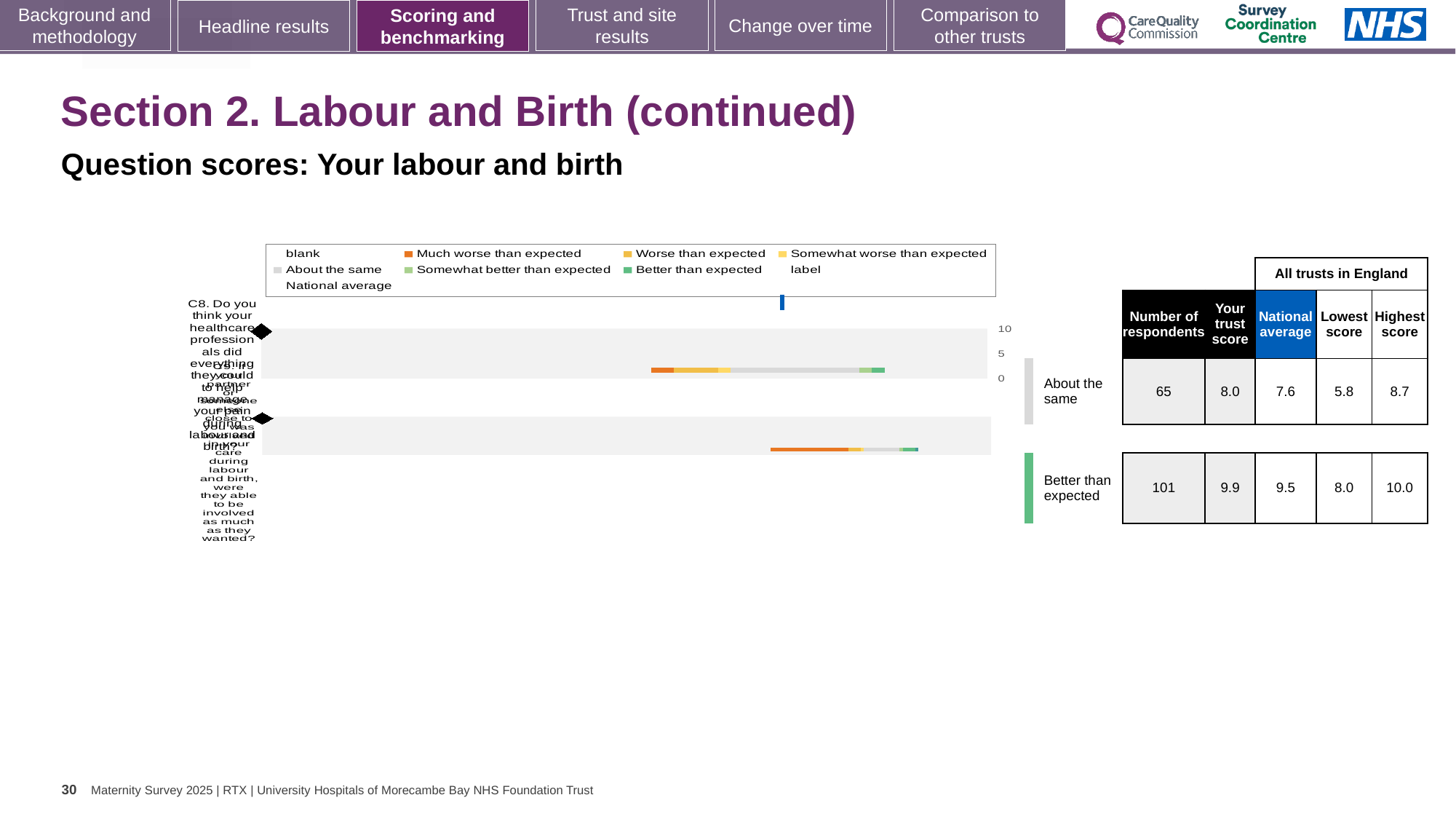
How many legend entries does the chart's legend list? 9 In the table beside the chart, what is the national average for the row rated 'About the same'? 7.6 In the table beside the chart, which row has the larger number of respondents, 'About the same' or 'Better than expected'? Better than expected Which legend entry is shown in orange in the chart's legend? Much worse than expected In the table beside the chart, what is the difference between the trust score and the national average for the row rated 'About the same'? 0.4 What kind of chart is shown on the slide? bar chart Which legend entry is shown in dark green in the chart's legend? Better than expected In the table beside the chart, what is the trust score for the row rated 'Better than expected'? 9.9 In the table beside the chart, what is the number of respondents for the row rated 'About the same'? 65 In the table beside the chart, what is the lowest score in England for the row rated 'About the same'? 5.8 In the table beside the chart, what is the highest score in England for the row rated 'Better than expected'? 10.0 How many question rows (bars) are plotted in the chart? 2